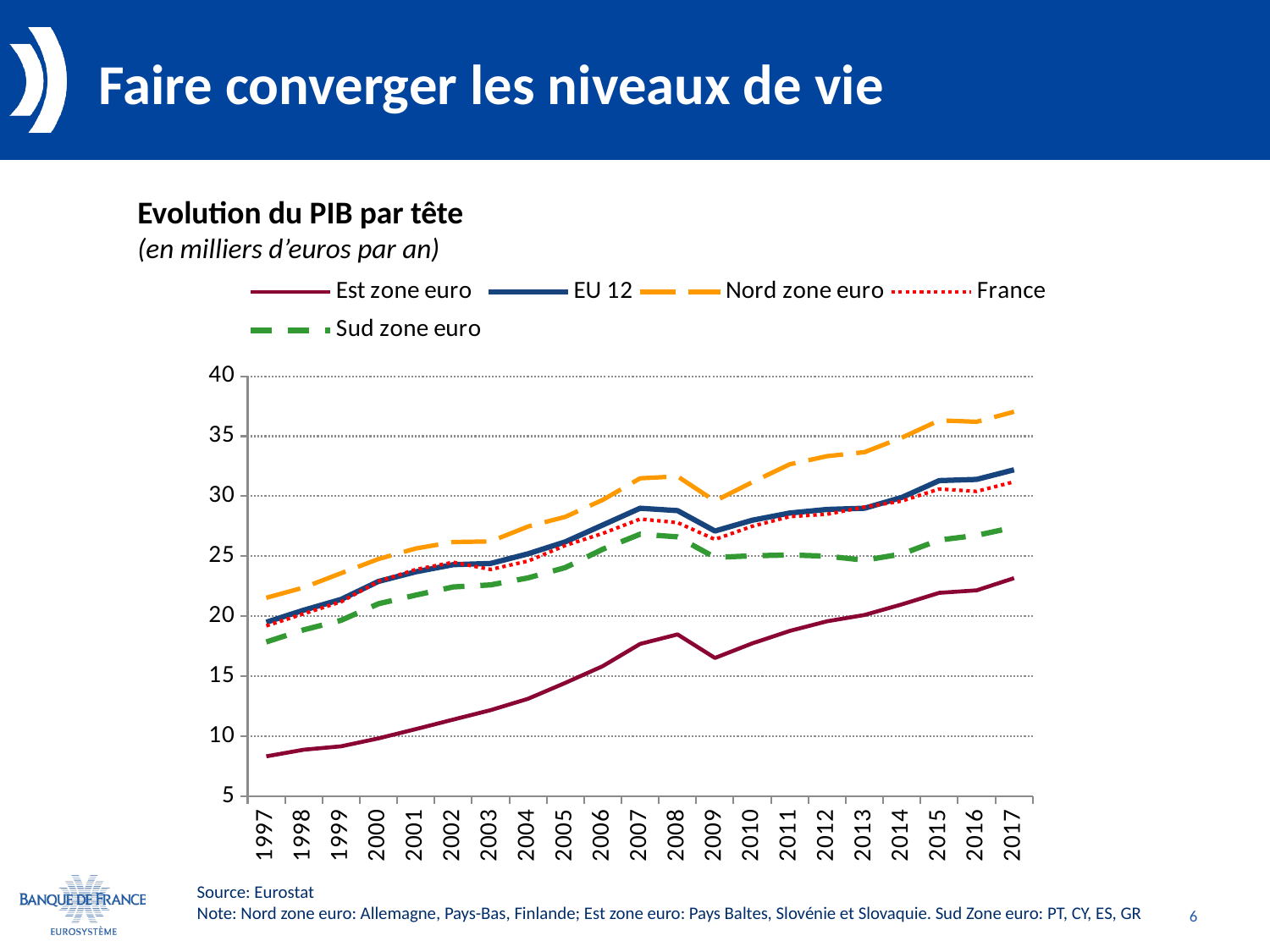
How many years are shown on the x axis? 21 Which series has the highest value in 2017? Nord zone euro Is the value for Nord zone euro in 2017 greater or less than 35? greater Is the value for Est zone euro in 2017 greater or less than 25? less In 2017, which is larger: Nord zone euro or Sud zone euro? Nord zone euro Is the value for Est zone euro in 1997 greater or less than 10? less Which series has the lowest value in 2017? Est zone euro What kind of chart is shown on the slide? line chart How many series does the legend list? 5 What is the title of the chart? Evolution du PIB par tête Does the Est zone euro series rise or fall overall from 1997 to 2017? rise